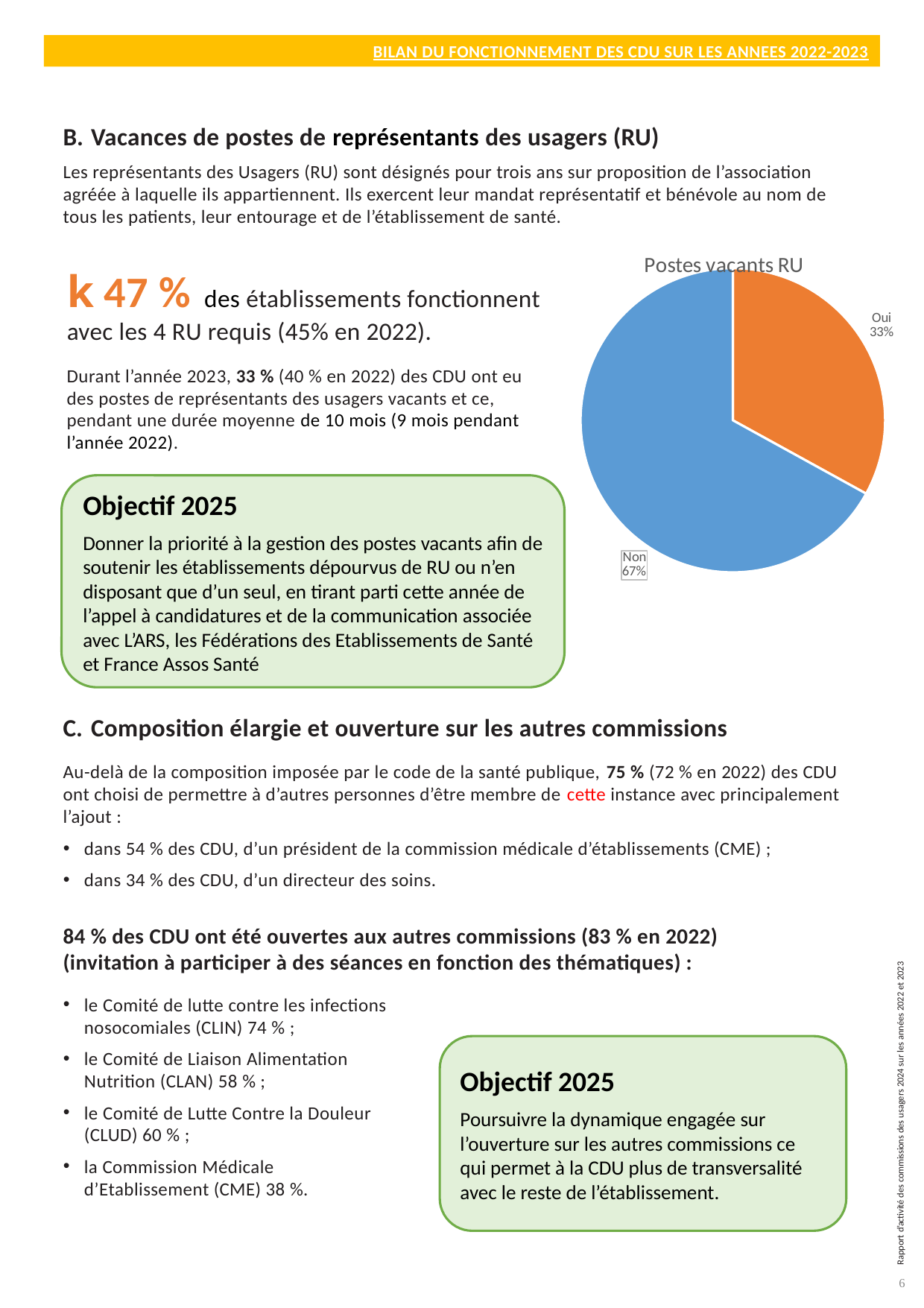
What type of chart is "Postes vacants RU"? pie chart Which slice of the pie chart is the largest? Non In the pie chart, which is larger, the "Oui" slice or the "Non" slice? Non How many slices does the pie chart have? 2 What share of the pie chart is labelled "Non"? 67% What share of the pie chart is labelled "Oui"? 33% What is the title of the pie chart? Postes vacants RU Which slice of the pie chart is the smallest? Oui What is the difference in percentage points between the "Non" and "Oui" slices of the pie chart? 34 Is the "Non" share in the pie chart greater or less than 50%? greater What colour is the "Oui" slice in the pie chart? orange